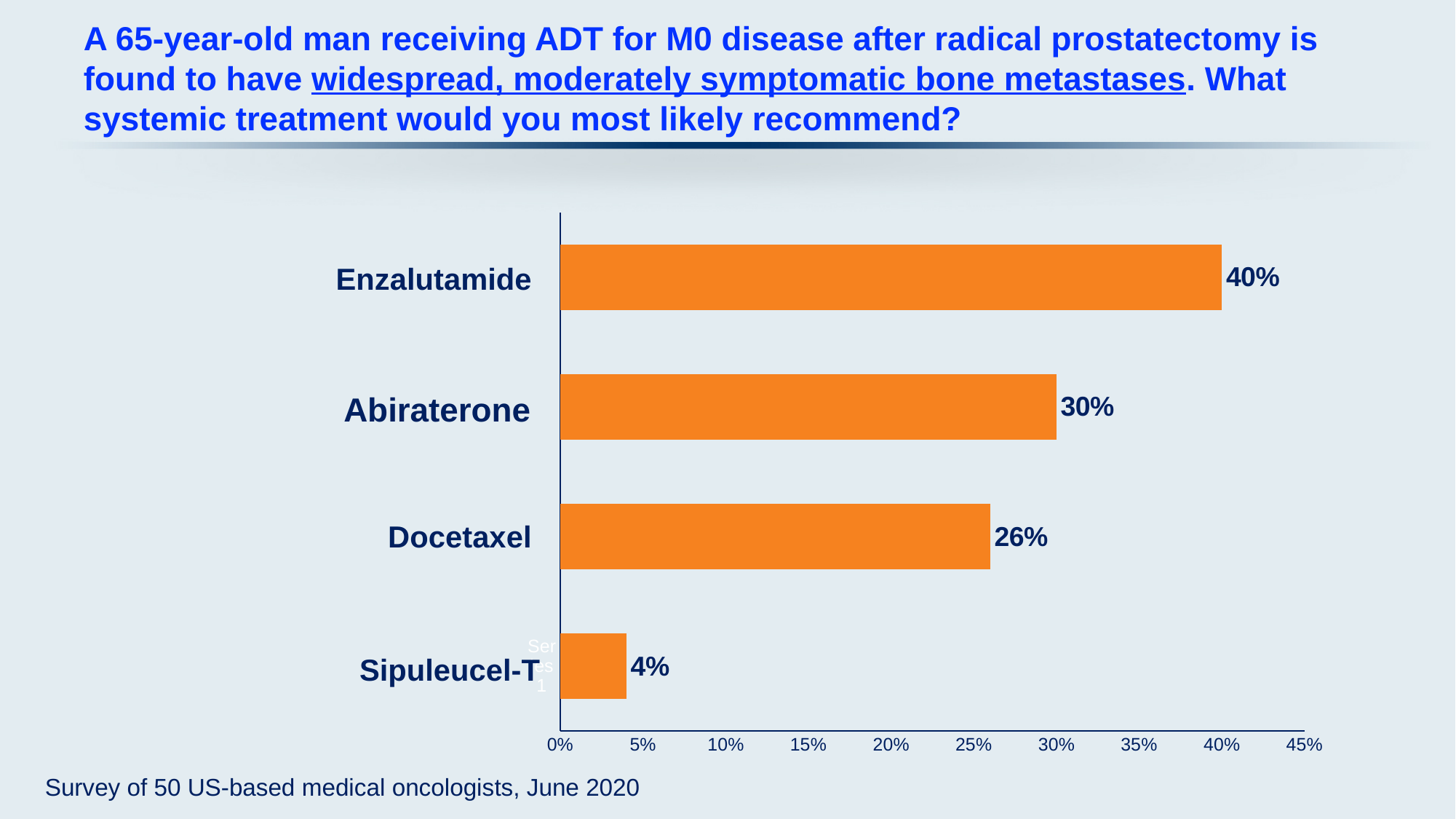
What percentage of respondents chose Docetaxel? 26% What percentage of respondents chose Abiraterone? 30% What percentage of respondents chose Enzalutamide? 40% What is the maximum value shown on the horizontal axis? 45% Which received a larger share of responses, Docetaxel or Sipuleucel-T? Docetaxel What percentage of respondents chose Sipuleucel-T? 4% What is the difference in percentage points between Enzalutamide and Abiraterone? 10 percentage points Which treatment was recommended by the lowest percentage of respondents? Sipuleucel-T How many treatment options are shown in the chart? 4 What is the difference in percentage points between Abiraterone and Docetaxel? 4 percentage points What type of chart is shown on the slide? Bar chart Which treatment was recommended by the highest percentage of respondents? Enzalutamide